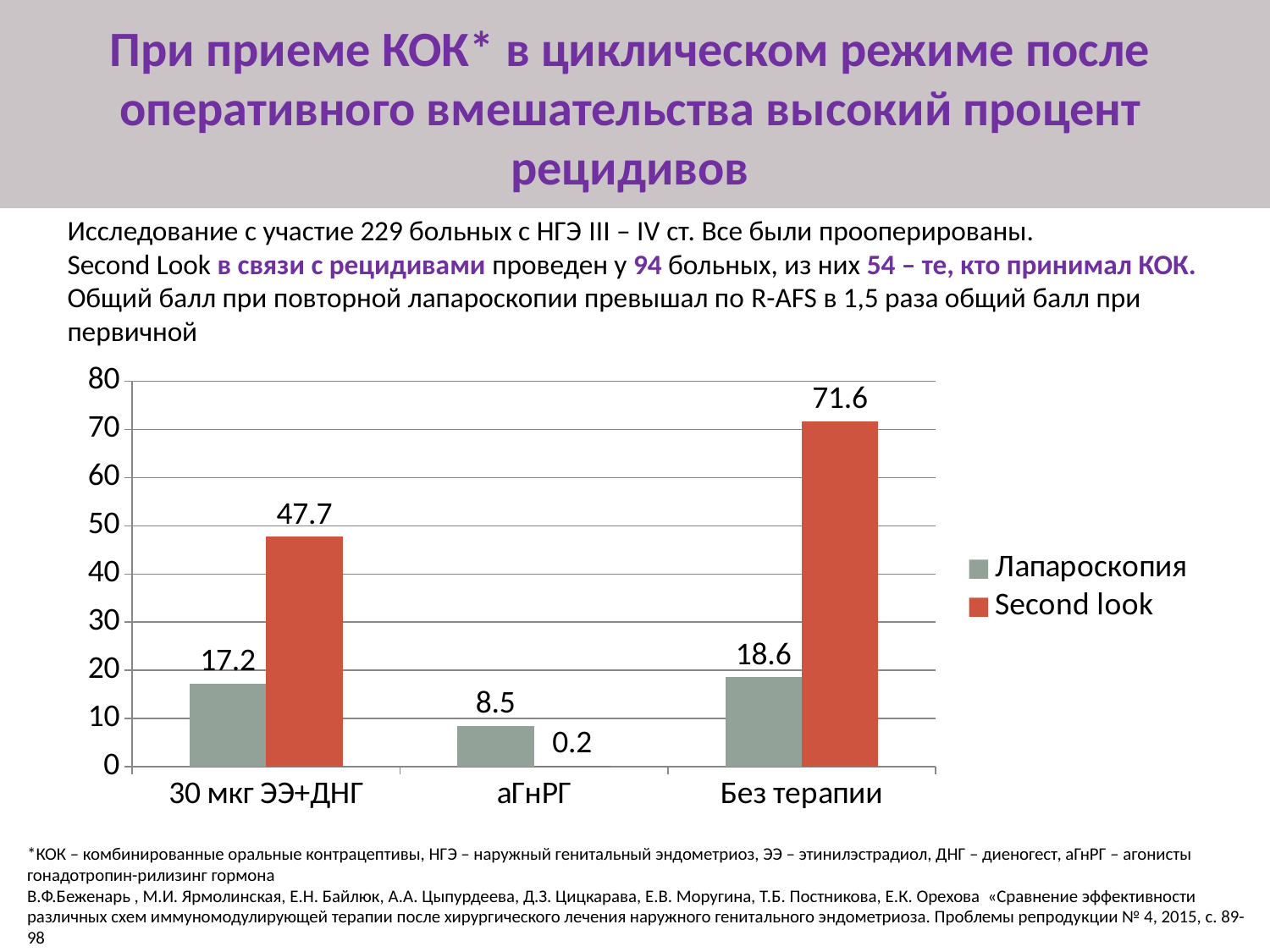
Which is larger for Без терапии: the Лапароскопия value or the Second look value? Second look Is the Second look value for 30 мкг ЭЭ+ДНГ greater or less than 40? greater How many series does the legend list? 2 Which category has the highest Second look value? Без терапии What is the Second look value for аГнРГ? 0.2 What is the Second look value for Без терапии? 71.6 What is the Лапароскопия value for 30 мкг ЭЭ+ДНГ? 17.2 What kind of chart is shown on the slide? bar chart How many categories are shown on the x axis? 3 What colour are the Second look bars? red Which category has the lowest Лапароскопия value? аГнРГ What is the difference between the Second look and Лапароскопия values for 30 мкг ЭЭ+ДНГ? 30.5